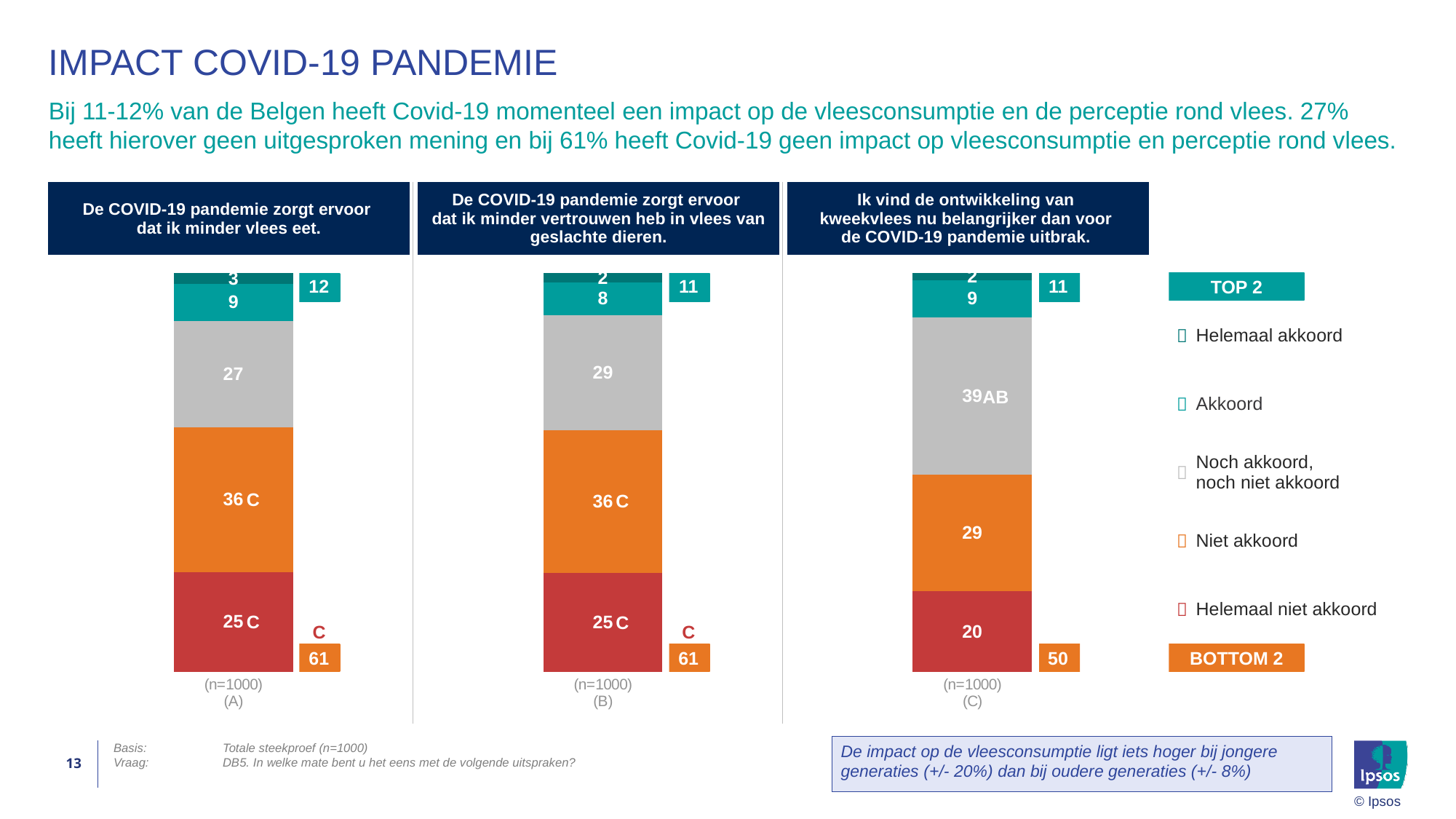
In the chart 'De COVID-19 pandemie zorgt ervoor dat ik minder vertrouwen heb in vlees van geslachte dieren', what is the value for 'Niet akkoord'? 36 What kind of chart is used for each of the three statements on the slide? Stacked bar chart In the chart 'De COVID-19 pandemie zorgt ervoor dat ik minder vlees eet', what is the value for 'Noch akkoord, noch niet akkoord'? 27 Is the 'Noch akkoord, noch niet akkoord' value larger in the chart 'De COVID-19 pandemie zorgt ervoor dat ik minder vertrouwen heb in vlees van geslachte dieren' or in the chart 'Ik vind de ontwikkeling van kweekvlees nu belangrijker dan voor de COVID-19 pandemie uitbrak'? Ik vind de ontwikkeling van kweekvlees nu belangrijker dan voor de COVID-19 pandemie uitbrak In the chart 'De COVID-19 pandemie zorgt ervoor dat ik minder vlees eet', which response category has the lowest value? Helemaal akkoord In the chart 'De COVID-19 pandemie zorgt ervoor dat ik minder vlees eet', what is the TOP 2 value? 12 In the chart 'Ik vind de ontwikkeling van kweekvlees nu belangrijker dan voor de COVID-19 pandemie uitbrak', which response category has the highest value? Noch akkoord, noch niet akkoord How many response categories does the legend list? 5 In the chart 'Ik vind de ontwikkeling van kweekvlees nu belangrijker dan voor de COVID-19 pandemie uitbrak', what is the BOTTOM 2 value? 50 In the chart 'Ik vind de ontwikkeling van kweekvlees nu belangrijker dan voor de COVID-19 pandemie uitbrak', what is the value for 'Helemaal niet akkoord'? 20 What is the sample size (n) shown under each chart? n=1000 What is the difference between the 'Niet akkoord' value in the chart 'De COVID-19 pandemie zorgt ervoor dat ik minder vlees eet' and the 'Niet akkoord' value in the chart 'Ik vind de ontwikkeling van kweekvlees nu belangrijker dan voor de COVID-19 pandemie uitbrak'? 7